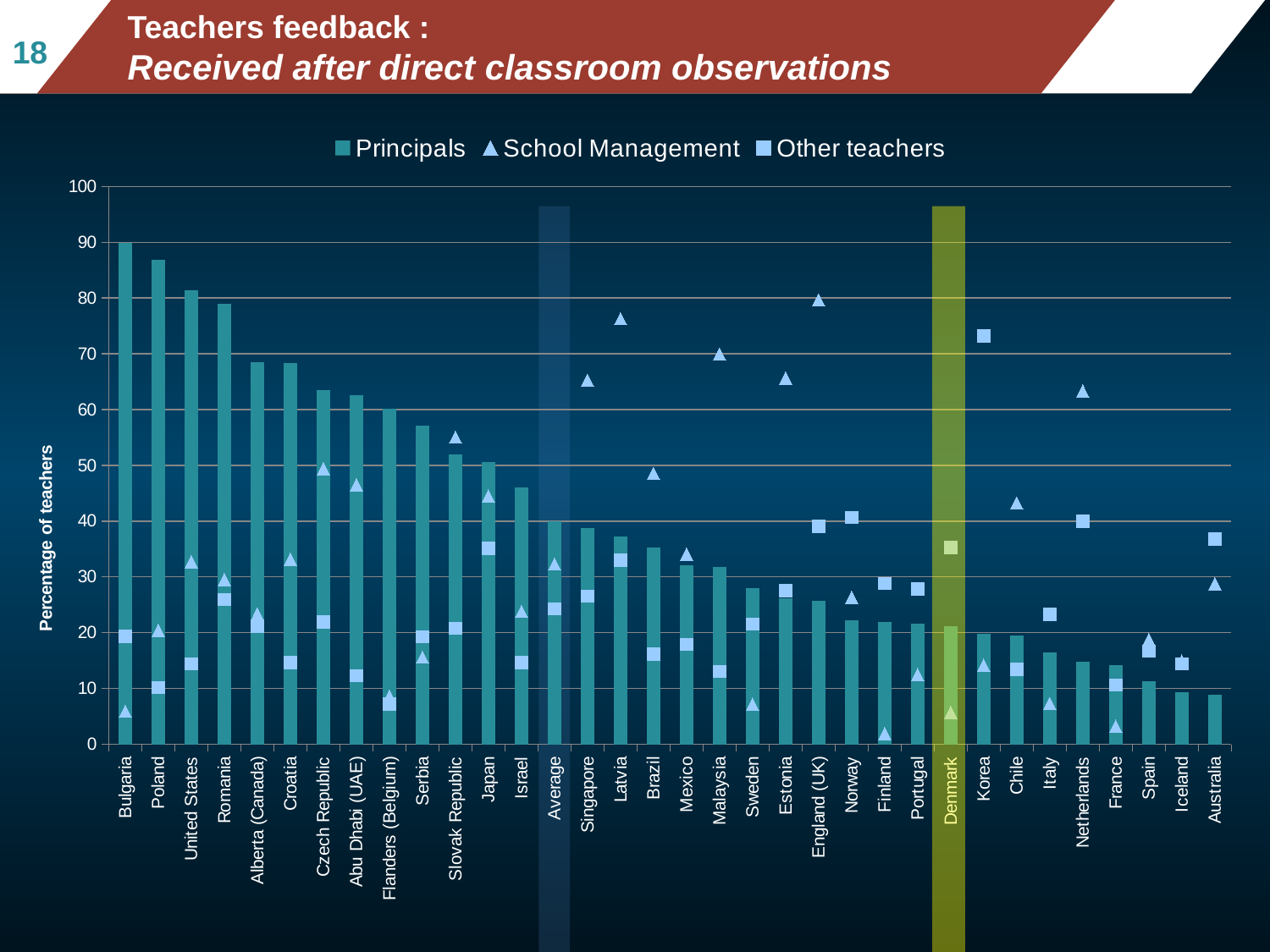
How many series does the legend list? 3 Is the Principals value for Australia greater or less than 10? less How many countries or categories are shown along the x axis? 34 Which category has the highest Other teachers value? Korea Do the Principals values generally rise or fall from left to right along the x axis? fall Is the Principals value for Poland greater or less than 80? greater Which category has the highest Principals value? Bulgaria Which category has the highest School Management value? England (UK) Is the Other teachers value for Denmark greater or less than 40? less What kind of chart is shown on the slide? bar chart Which has the larger School Management value, Latvia or Brazil? Latvia What is the label on the vertical axis? Percentage of teachers